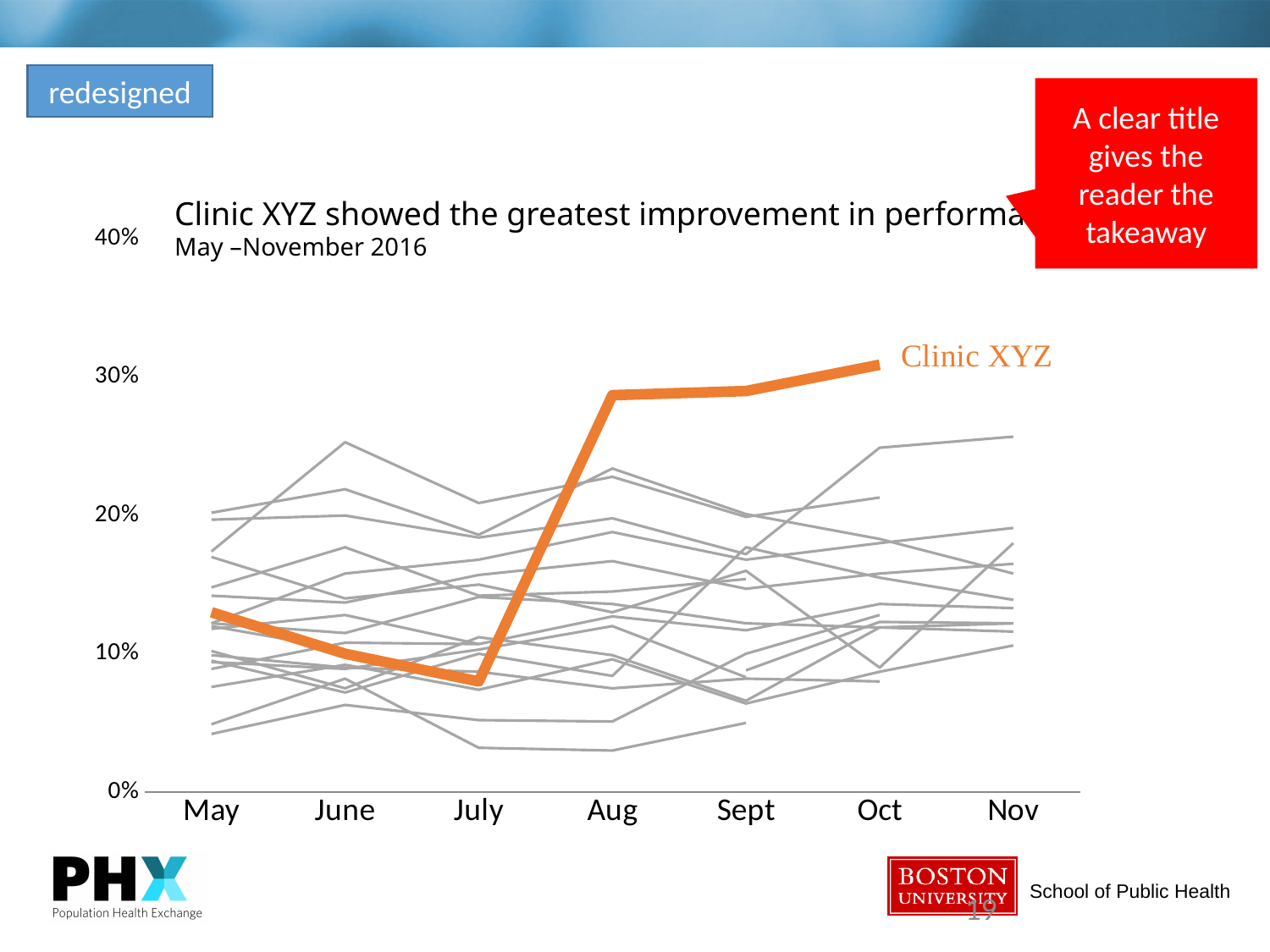
Is the value for Clinic XYZ in May greater or less than 10%? greater Does the Clinic XYZ line rise or fall between July and Aug? rise Is the value for Clinic XYZ in Aug greater or less than 20%? greater In which month does the Clinic XYZ line reach its highest point? Oct Which line in the chart is highlighted in orange? Clinic XYZ Is the value for Clinic XYZ in July greater or less than 10%? less Which is larger for Clinic XYZ, the value in Aug or the value in June? Aug What kind of chart is shown on the slide? line chart What time period does the chart's subtitle give? May –November 2016 How many months are shown along the x axis of the chart? 7 Does the Clinic XYZ line rise or fall between May and July? fall In which month is the Clinic XYZ line at its lowest point? July